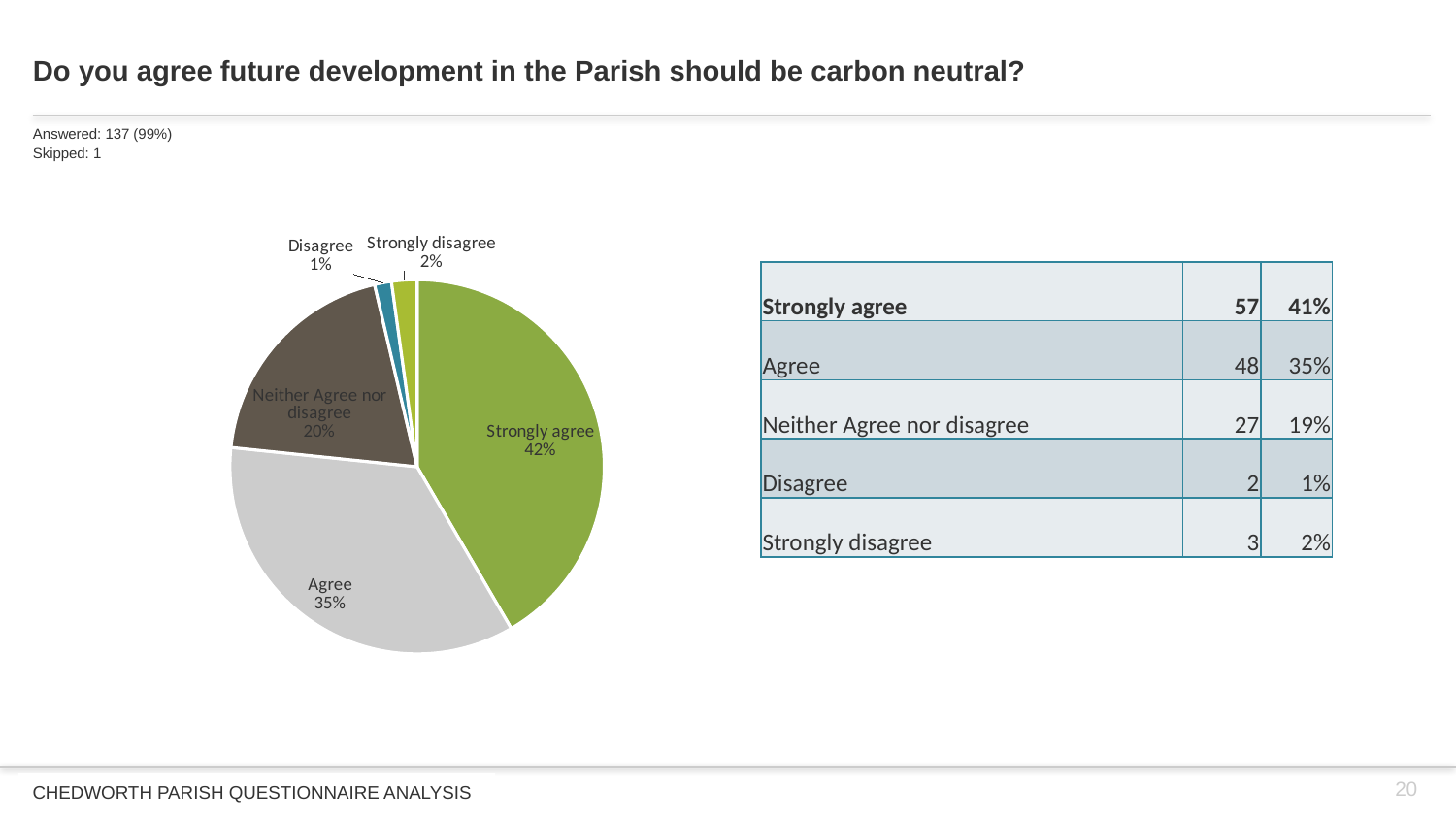
In the pie chart, which is larger: the 'Agree' slice or the 'Neither Agree nor disagree' slice? Agree According to the pie chart's data label, what share of responses is 'Agree'? 35% Which slice of the pie chart is the largest? Strongly agree What colour is the 'Strongly agree' slice in the pie chart? green According to the pie chart's data label, what share of responses is 'Strongly agree'? 42% According to the pie chart's data label, what share of responses is 'Neither Agree nor disagree'? 20% What kind of chart is shown on the slide? pie chart Using the pie chart's data labels, what is the difference in percentage points between 'Agree' and 'Neither Agree nor disagree'? 15% According to the pie chart's data label, what share of responses is 'Disagree'? 1% Which slice of the pie chart is the smallest? Disagree According to the pie chart's data label, what share of responses is 'Strongly disagree'? 2% How many slices does the pie chart have? 5